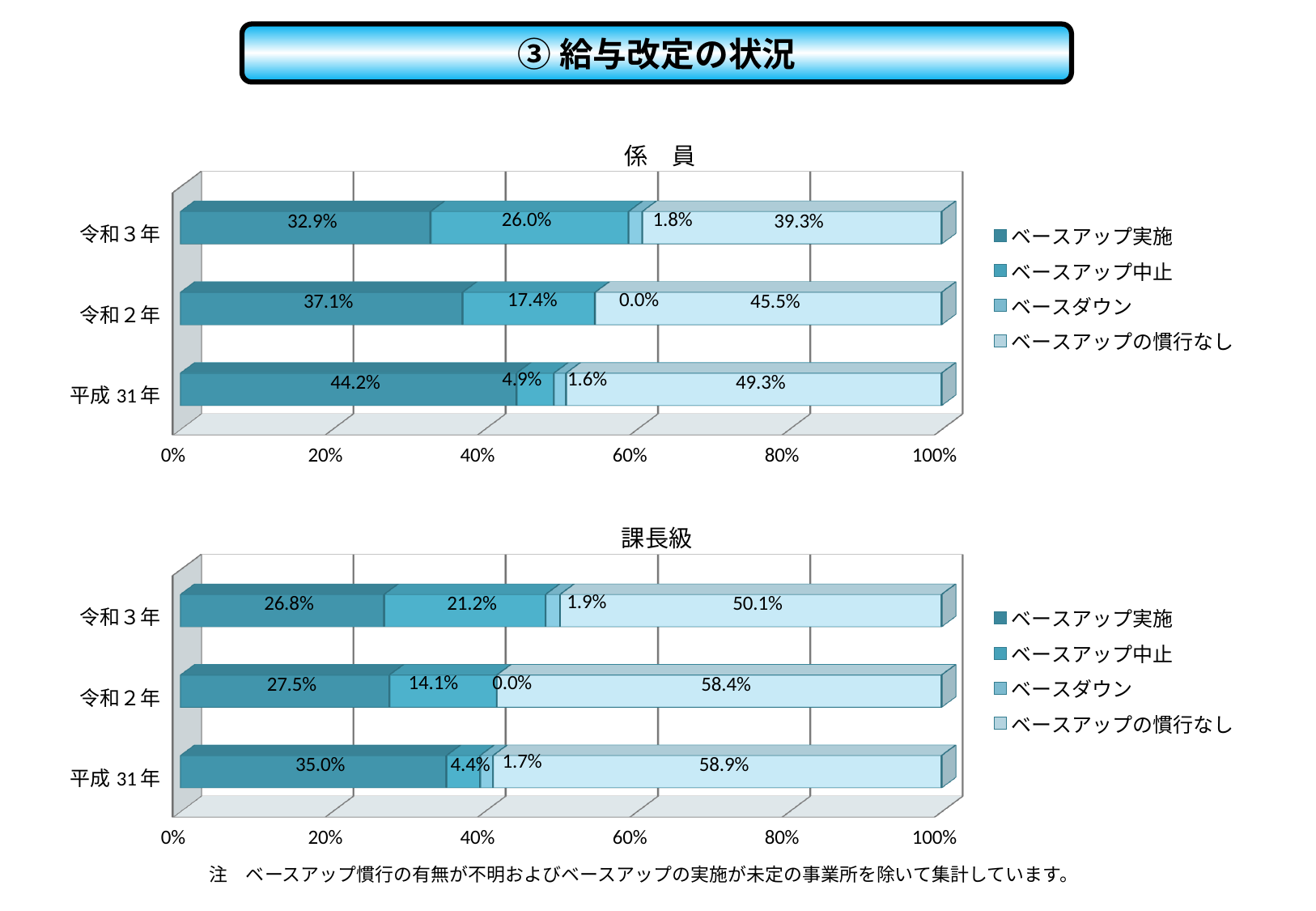
In the 係員 chart, what is the difference between ベースアップ実施 for 平成31年 and for 令和３年? 11.3% In the 係員 chart, what is the value of ベースアップの慣行なし for 平成31年? 49.3% In the 課長級 chart, which year has the lowest value for ベースアップ中止? 平成31年 In the 課長級 chart, what is the value of ベースアップ中止 for 令和２年? 14.1% How many series does the legend of the 係員 chart list? 4 In the 課長級 chart, does the value of ベースアップ実施 rise or fall from 平成31年 to 令和３年? Fall In the 係員 chart, which year has the highest value for ベースアップ実施? 平成31年 What kind of chart is the 係員 chart? Stacked bar chart In the 課長級 chart, what is the value of ベースダウン for 令和３年? 1.9% How many years are shown in the 課長級 chart? 3 In the 課長級 chart, which is larger: ベースアップの慣行なし for 令和２年 or for 令和３年? 令和２年 In the 係員 chart, what is the value of ベースアップ実施 for 令和３年? 32.9%